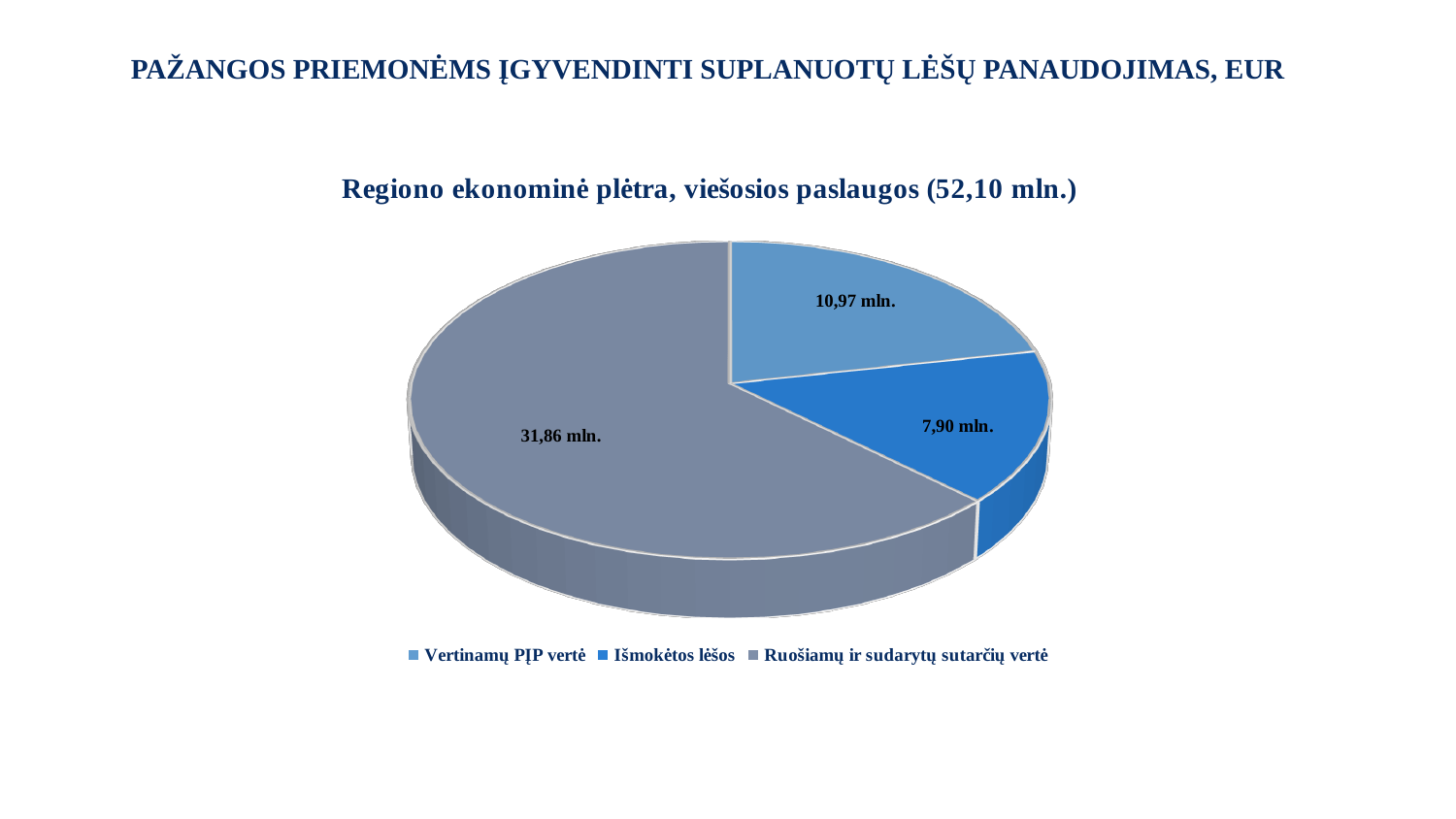
Which legend entry is shown in grey? Ruošiamų ir sudarytų sutarčių vertė What kind of chart is shown on the slide? Pie chart Which is larger, Vertinamų PĮP vertė or Išmokėtos lėšos? Vertinamų PĮP vertė What is the title of the pie chart? Regiono ekonominė plėtra, viešosios paslaugos (52,10 mln.) What is the value of the Išmokėtos lėšos slice? 7,90 mln. What is the value of the Vertinamų PĮP vertė slice? 10,97 mln. Which category has the smallest slice of the pie? Išmokėtos lėšos How many slices does the pie chart have? 3 What is the difference between the Ruošiamų ir sudarytų sutarčių vertė slice and the Vertinamų PĮP vertė slice? 20,89 mln. Which category has the largest slice of the pie? Ruošiamų ir sudarytų sutarčių vertė What is the value of the Ruošiamų ir sudarytų sutarčių vertė slice? 31,86 mln. What is the difference between the Vertinamų PĮP vertė slice and the Išmokėtos lėšos slice? 3,07 mln.